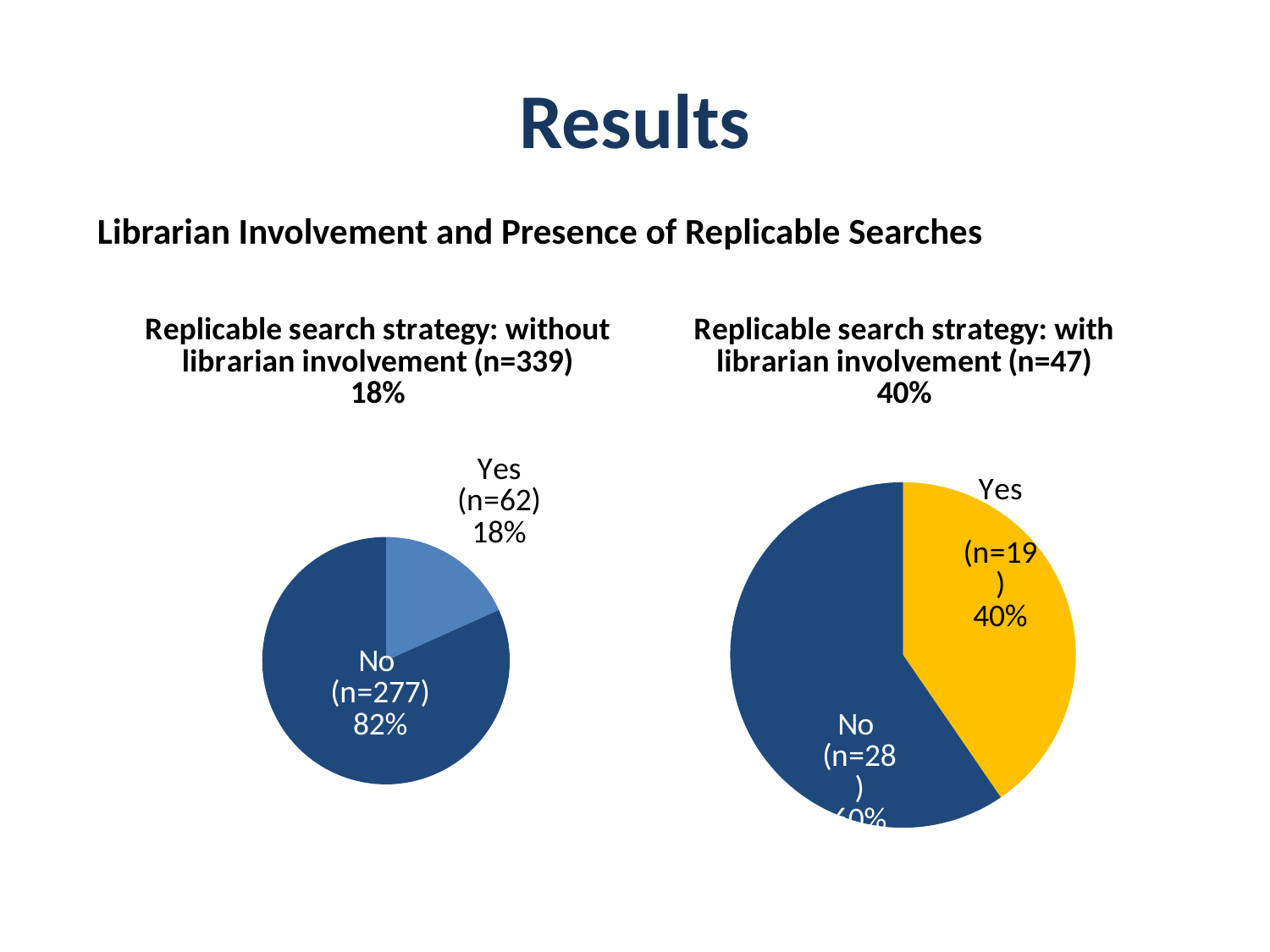
In the left pie chart (without librarian involvement), what is the difference in percentage points between the "No" and "Yes" slices? 64 percentage points In the left pie chart (without librarian involvement), how many studies are in the "No" slice? n=277 In the right pie chart (with librarian involvement), how many studies are in the "No" slice? n=28 What is the total sample size (n) given in the title of the right pie chart (with librarian involvement)? n=47 In the left pie chart (without librarian involvement), what percentage is shown for the "Yes" slice? 18% How many slices does the right pie chart (with librarian involvement) have? 2 In the right pie chart (with librarian involvement), what percentage is shown for the "Yes" slice? 40% In the right pie chart (with librarian involvement), how many studies are in the "Yes" slice? n=19 In the left pie chart (without librarian involvement), how many studies are in the "Yes" slice? n=62 In the left pie chart (without librarian involvement), which slice is larger, "Yes" or "No"? No In the left pie chart (without librarian involvement), what percentage is shown for the "No" slice? 82% What kind of chart is used on the left, titled "Replicable search strategy: without librarian involvement"? Pie chart